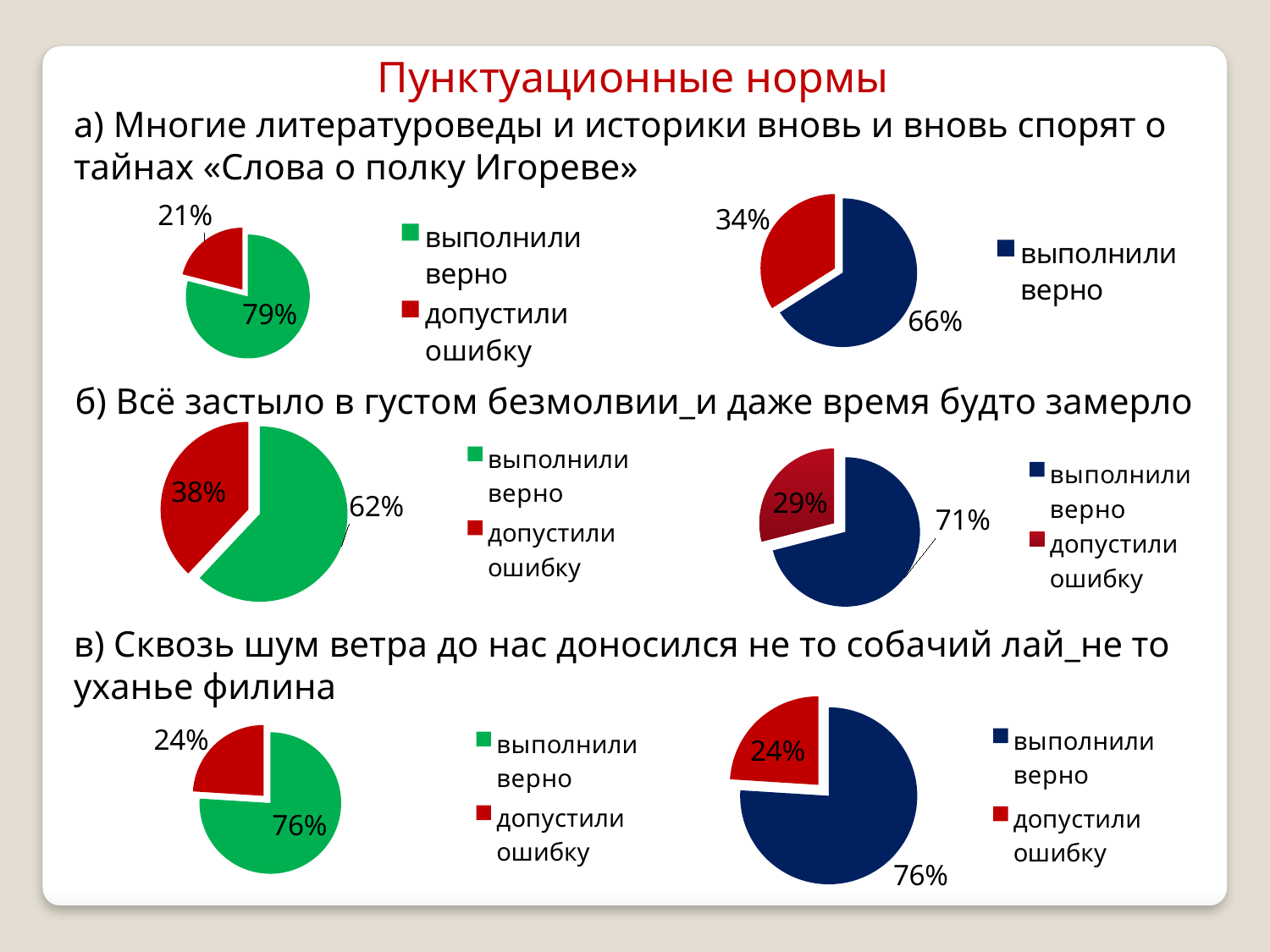
In the right pie chart under sentence в), what share is labelled "выполнили верно"? 76% In the left pie chart under sentence a), what share of the pie is labelled "выполнили верно"? 79% In the left pie chart under sentence a), what share is labelled "допустили ошибку"? 21% In the right pie chart under sentence a), what is the value printed on the red slice? 34% What type of chart is used for the chart on the left under sentence в)? Pie chart In the right pie chart under sentence б), which slice is larger, "выполнили верно" or "допустили ошибку"? выполнили верно How many entries does the legend of the right pie chart under sentence a) list? 1 In the left pie chart under sentence б), what is the difference between the "выполнили верно" and "допустили ошибку" shares? 24%